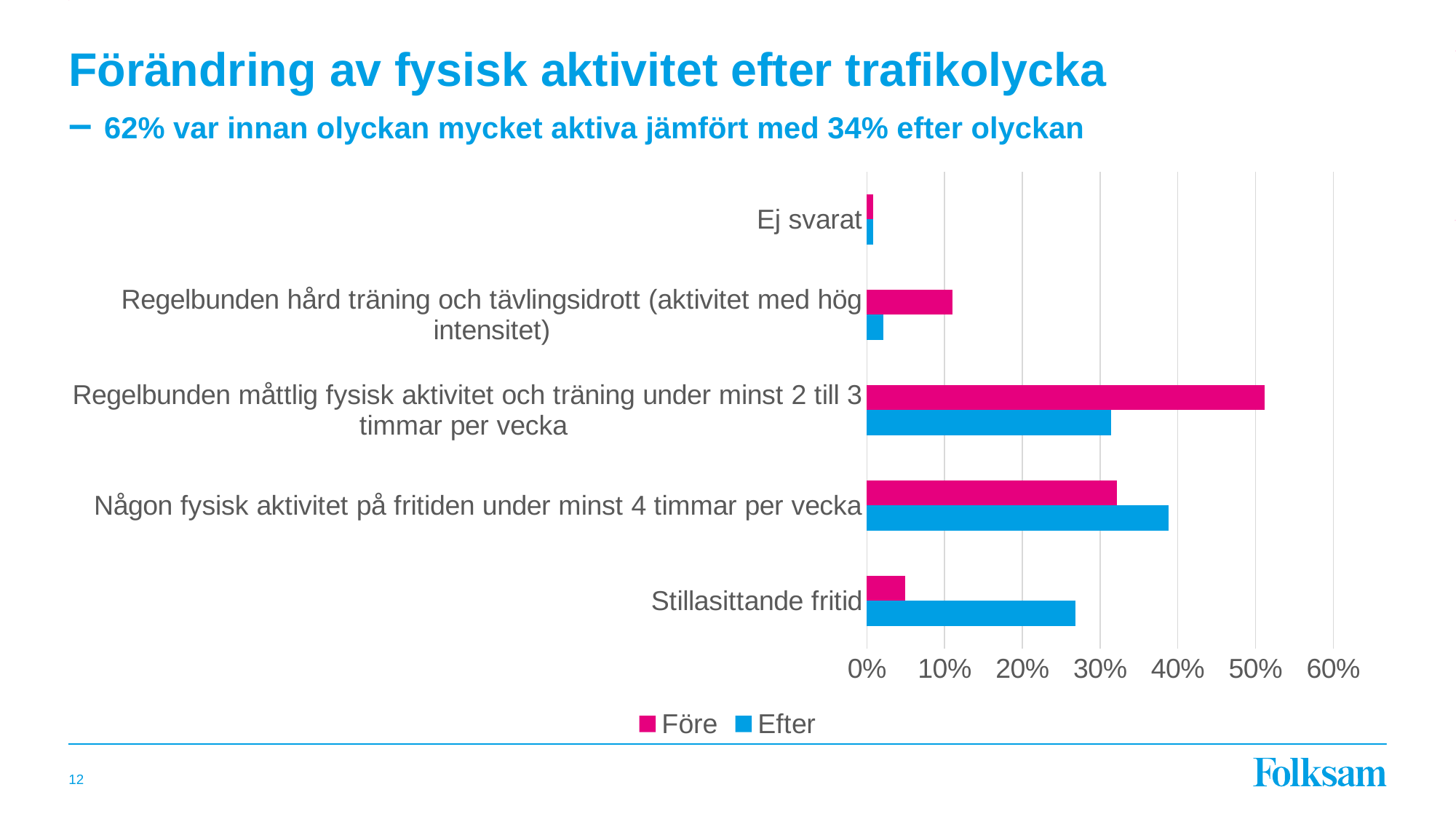
Is the Före value for Regelbunden måttlig fysisk aktivitet och träning under minst 2 till 3 timmar per vecka greater or less than 50%? greater Which series is shown in pink? Före Is the Före value for Stillasittande fritid greater or less than 10%? less Which category has the highest Före value? Regelbunden måttlig fysisk aktivitet och träning under minst 2 till 3 timmar per vecka Which category has the lowest Efter value? Ej svarat How many categories are shown on the chart? 5 What kind of chart is shown on the slide? bar chart Which category has the highest Efter value? Någon fysisk aktivitet på fritiden under minst 4 timmar per vecka For Stillasittande fritid, which is larger, the Före value or the Efter value? Efter How many series does the legend list? 2 For Regelbunden hård träning och tävlingsidrott (aktivitet med hög intensitet), which is larger, the Före value or the Efter value? Före Is the Efter value for Stillasittande fritid greater or less than 20%? greater